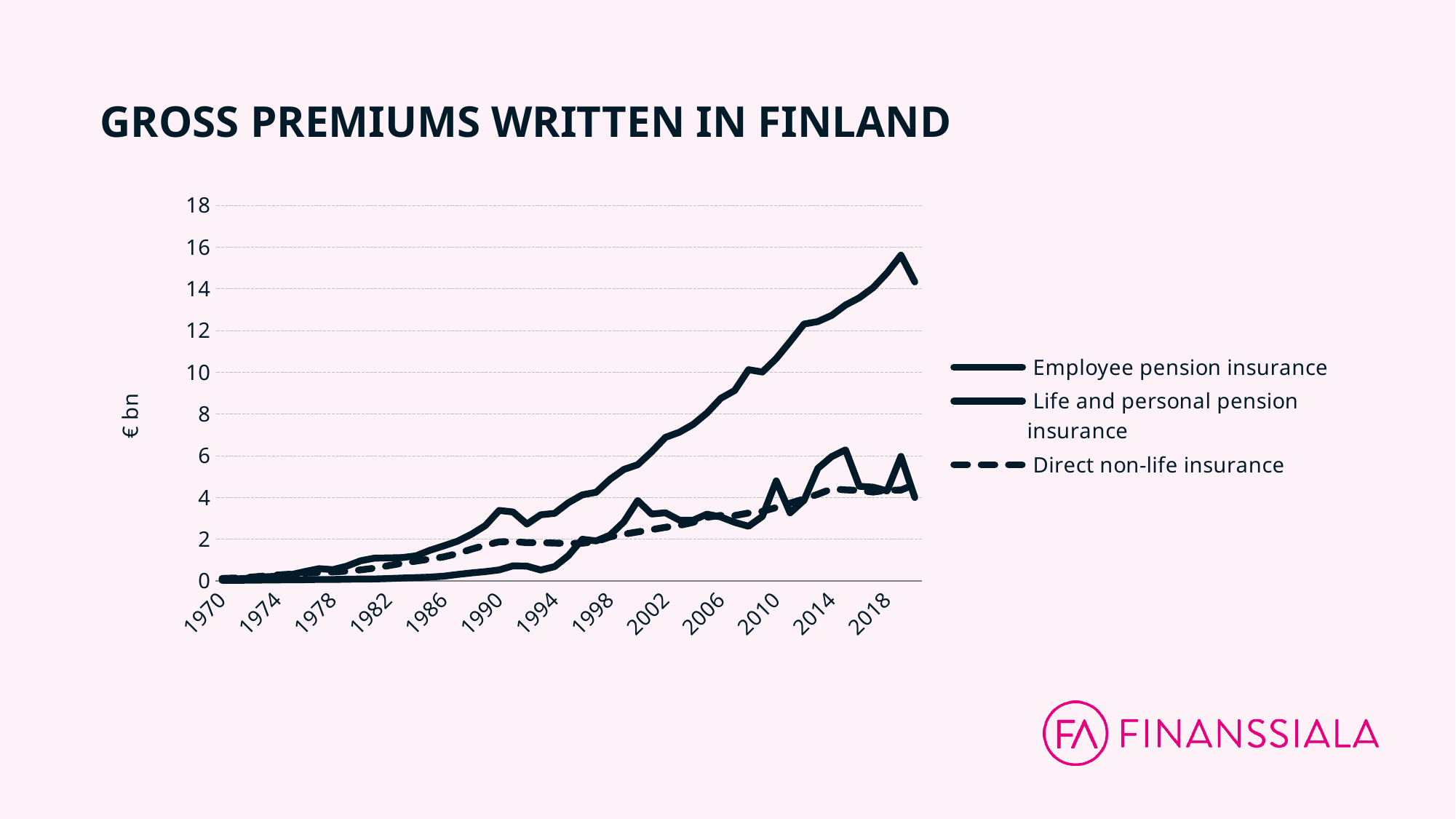
What is the label on the vertical axis? € bn How many series does the legend list? 3 In 2010, which is larger: Employee pension insurance or Direct non-life insurance? Employee pension insurance Is the value for Employee pension insurance in 2018 greater or less than 12? greater What is the title of the chart? GROSS PREMIUMS WRITTEN IN FINLAND Which series is drawn with a dashed line? Direct non-life insurance Does the Employee pension insurance line generally rise or fall from 1970 to 2018? Rise What kind of chart is shown on the slide? Line chart Which series has the highest value at the right end of the chart? Employee pension insurance Is the value for Direct non-life insurance in 2018 greater or less than 6? less Which series has the lowest value in 1990? Life and personal pension insurance Is the value for Employee pension insurance in 2014 greater or less than 10? greater